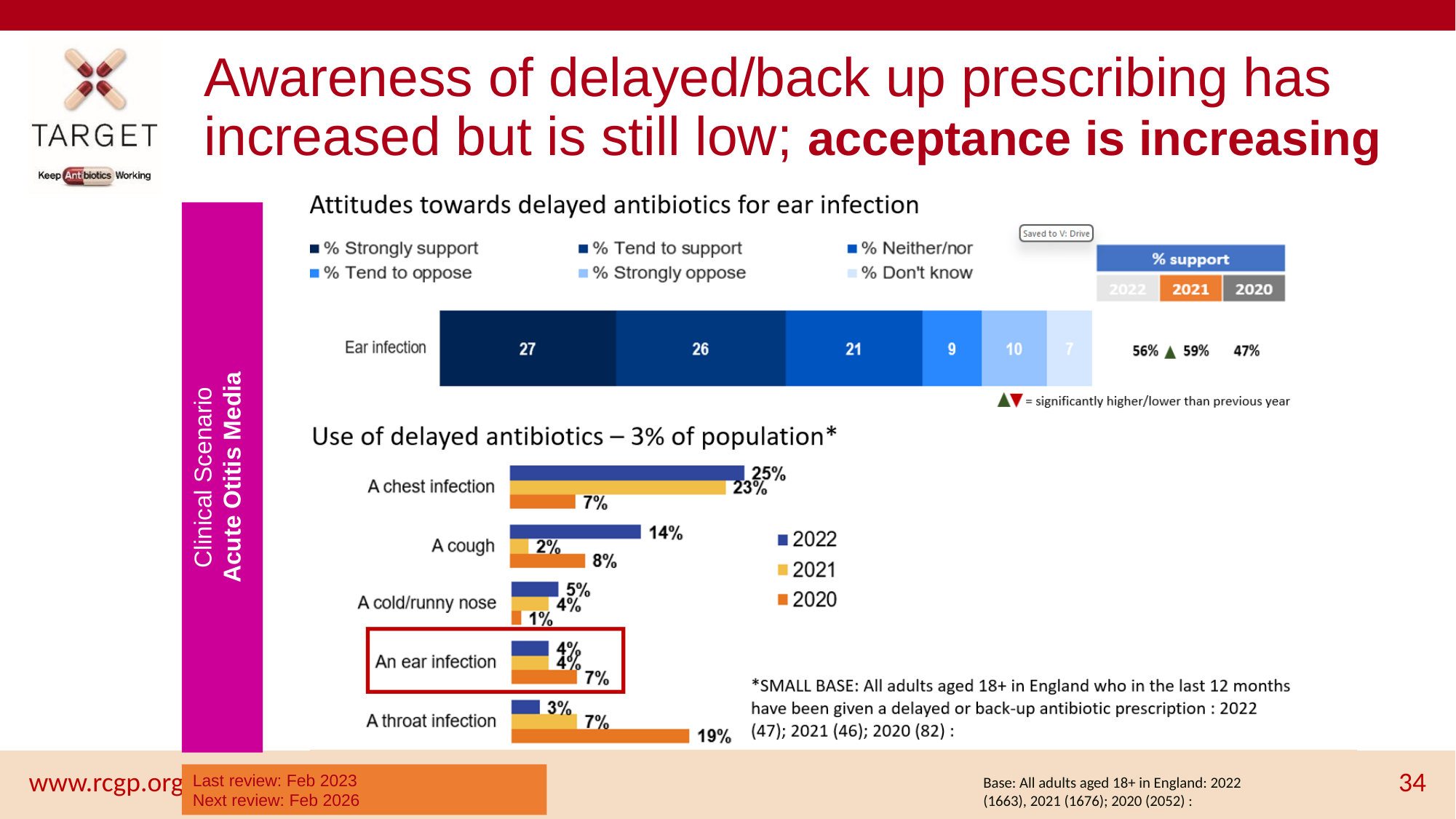
In the 'Use of delayed antibiotics' chart, how many categories are shown? 5 In the 'Use of delayed antibiotics' chart, is the 2021 value for 'A cough' larger or smaller than the 2020 value for 'A cough'? smaller In the 'Attitudes towards delayed antibiotics for ear infection' chart, what is the value for '% Strongly support'? 27 In the 'Use of delayed antibiotics' chart, what is the 2022 value for 'A chest infection'? 25% In the 'Use of delayed antibiotics' chart, what is the 2020 value for 'A throat infection'? 19% In the 'Attitudes towards delayed antibiotics for ear infection' chart, what is the value for '% Tend to oppose'? 9 In the 'Attitudes towards delayed antibiotics for ear infection' chart, how many series does the legend list? 6 In the 'Attitudes towards delayed antibiotics for ear infection' chart, what is the % support figure shown for 2021? 59% In the 'Use of delayed antibiotics' chart, which category has the highest 2022 value? A chest infection What kind of chart is the 'Use of delayed antibiotics' chart? Bar chart In the 'Attitudes towards delayed antibiotics for ear infection' chart, what is the difference between '% Strongly support' and '% Neither/nor'? 6 In the 'Use of delayed antibiotics' chart, which category has the lowest 2020 value? A cold/runny nose